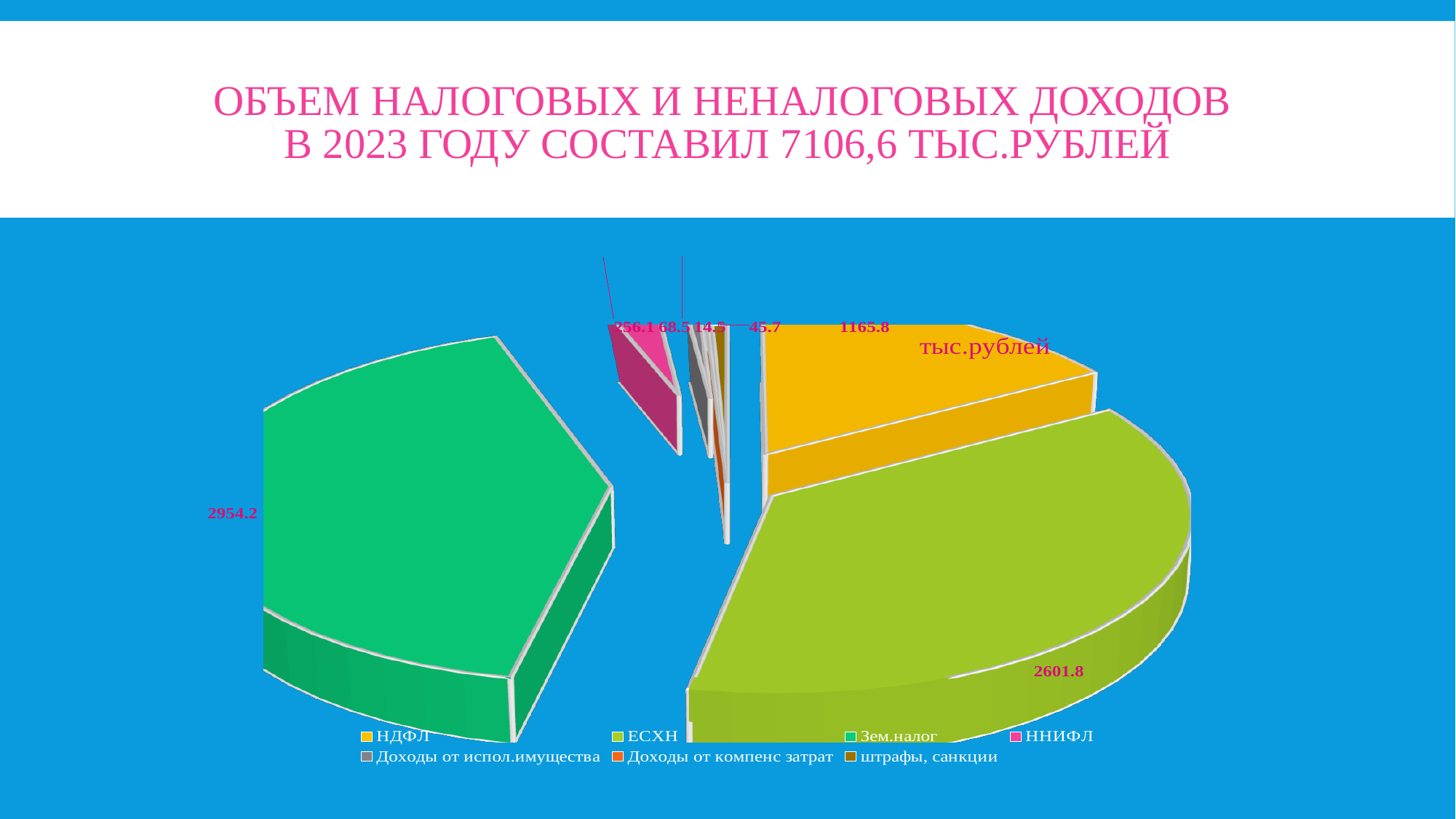
What is the value shown for Зем.налог? 2954.2 What is the value shown for НДФЛ? 1165.8 Which is larger, the value for НДФЛ or the value for ННИФЛ? НДФЛ What is the value shown for ННИФЛ? 256.1 Which category has the largest slice in the pie chart? Зем.налог What unit label is printed next to the pie chart? тыс.рублей How many categories does the legend of the pie chart list? 7 What is the difference between the values for ЕСХН and НДФЛ? 1436.0 What is the value shown for Доходы от испол.имущества? 68.5 What is the difference between the values for Зем.налог and ЕСХН? 352.4 What is the value shown for ЕСХН? 2601.8 What kind of chart is shown on the slide? pie chart